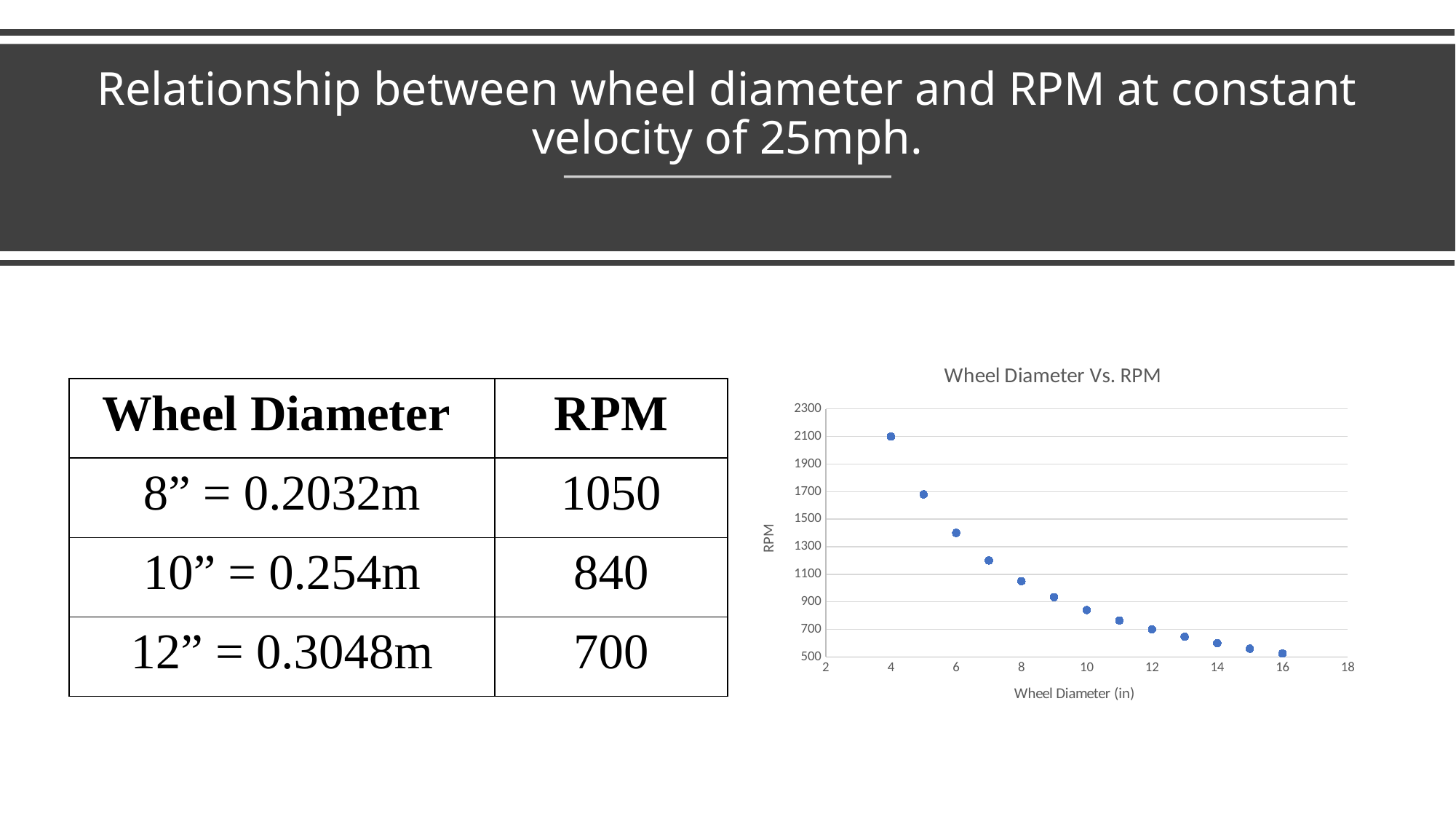
How many data points are plotted in the chart? 13 Is the RPM for a wheel diameter of 6 inches greater or less than 1300? greater What is the title of the chart? Wheel Diameter Vs. RPM Which has the higher RPM, a wheel diameter of 8 inches or 12 inches? 8 inches What is the label of the x axis of the chart? Wheel Diameter (in) Is the RPM for a wheel diameter of 16 inches greater or less than 700? less What kind of chart is shown on the slide? scatter chart At which wheel diameter is the RPM highest in the chart? 4 Is the RPM for a wheel diameter of 4 inches greater or less than 1900? greater At which wheel diameter is the RPM lowest in the chart? 16 As wheel diameter increases along the x axis, does RPM rise or fall? fall According to the table on the slide, what is the RPM for a 10 inch wheel diameter? 840